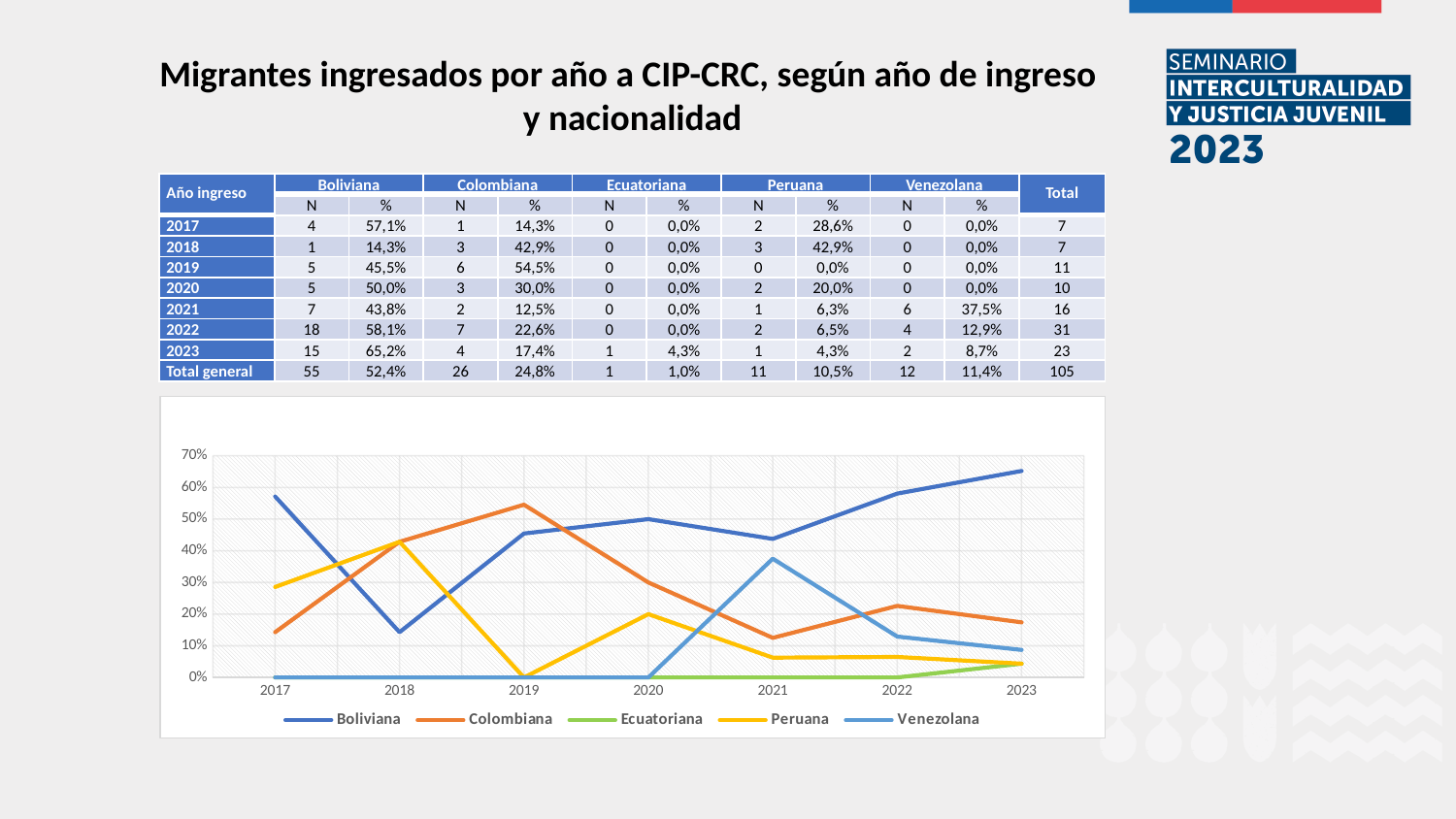
What is the percentage for Boliviana in 2023? 65,2% Is the value for Venezolana in 2021 greater or less than 30%? greater How many series does the chart legend list? 5 In 2019, which is larger: the percentage for Colombiana or for Boliviana? Colombiana Which nationality has the highest percentage in 2017? Boliviana What is the difference in percentage points between Boliviana and Colombiana in 2023? 47,8 Is the value for Venezolana in 2022 greater or less than 20%? less How many years are plotted along the x axis of the chart? 7 Which nationality has the highest percentage in 2023? Boliviana What is the percentage for Peruana in 2020? 20,0% Between 2021 and 2023, does the Boliviana line rise or fall? rise What kind of chart is shown on the slide? line chart